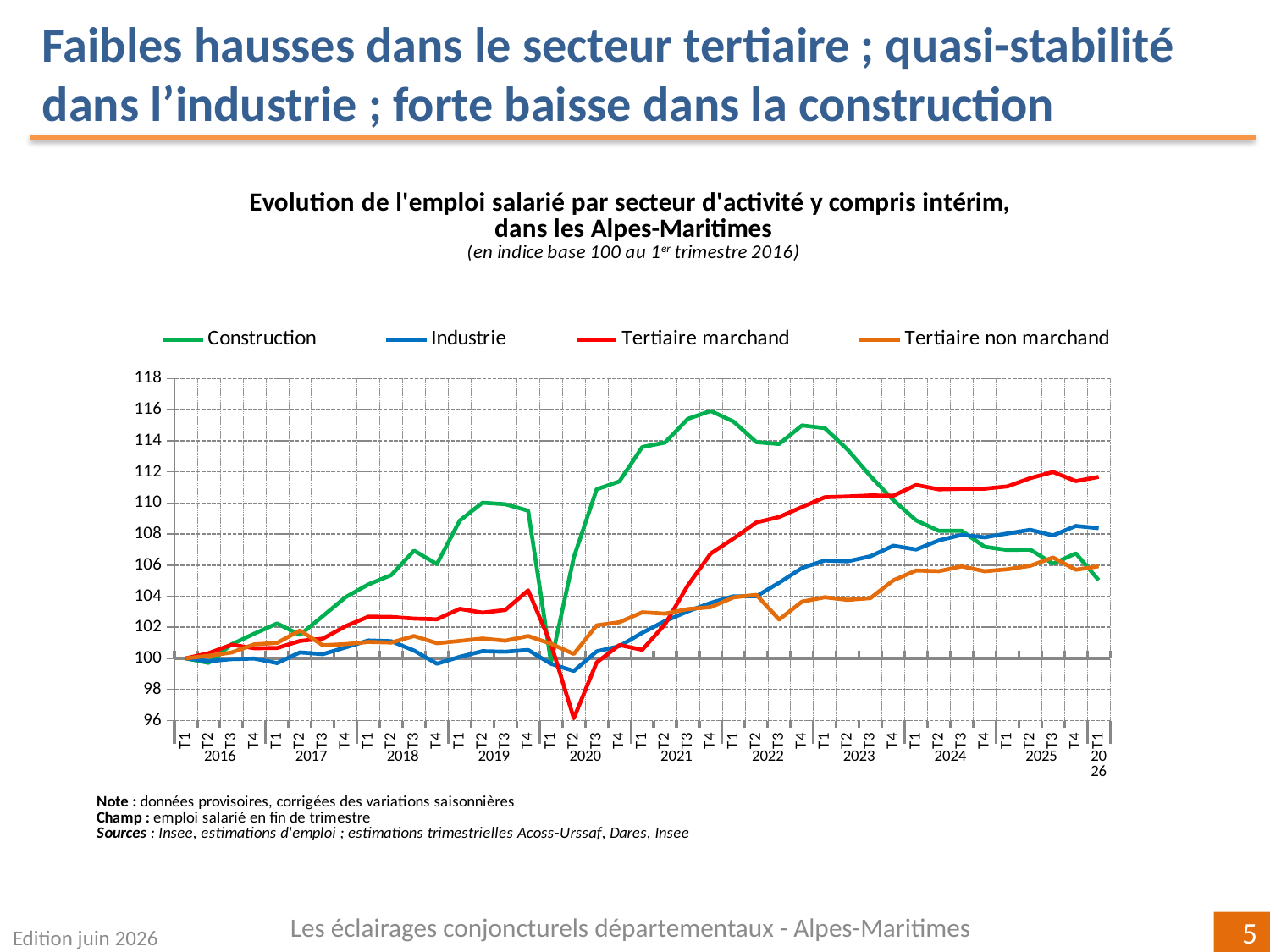
Which series falls to the lowest point anywhere on the chart? Tertiaire marchand How many year labels appear along the x axis? 11 How many series does the legend list? 4 Does the Construction series rise or fall between T1 2024 and T1 2026? fall What colour is the Construction line? green What kind of chart is shown on the slide? line chart Is the value for Tertiaire non marchand at T1 2026 greater or less than 108? less Is the value for Tertiaire marchand at T2 2020 greater or less than 98? less Is the value for Construction at T4 2021 greater or less than 114? greater Which series reaches the highest point anywhere on the chart? Construction At T1 2026, which is higher: Tertiaire marchand or Construction? Tertiaire marchand